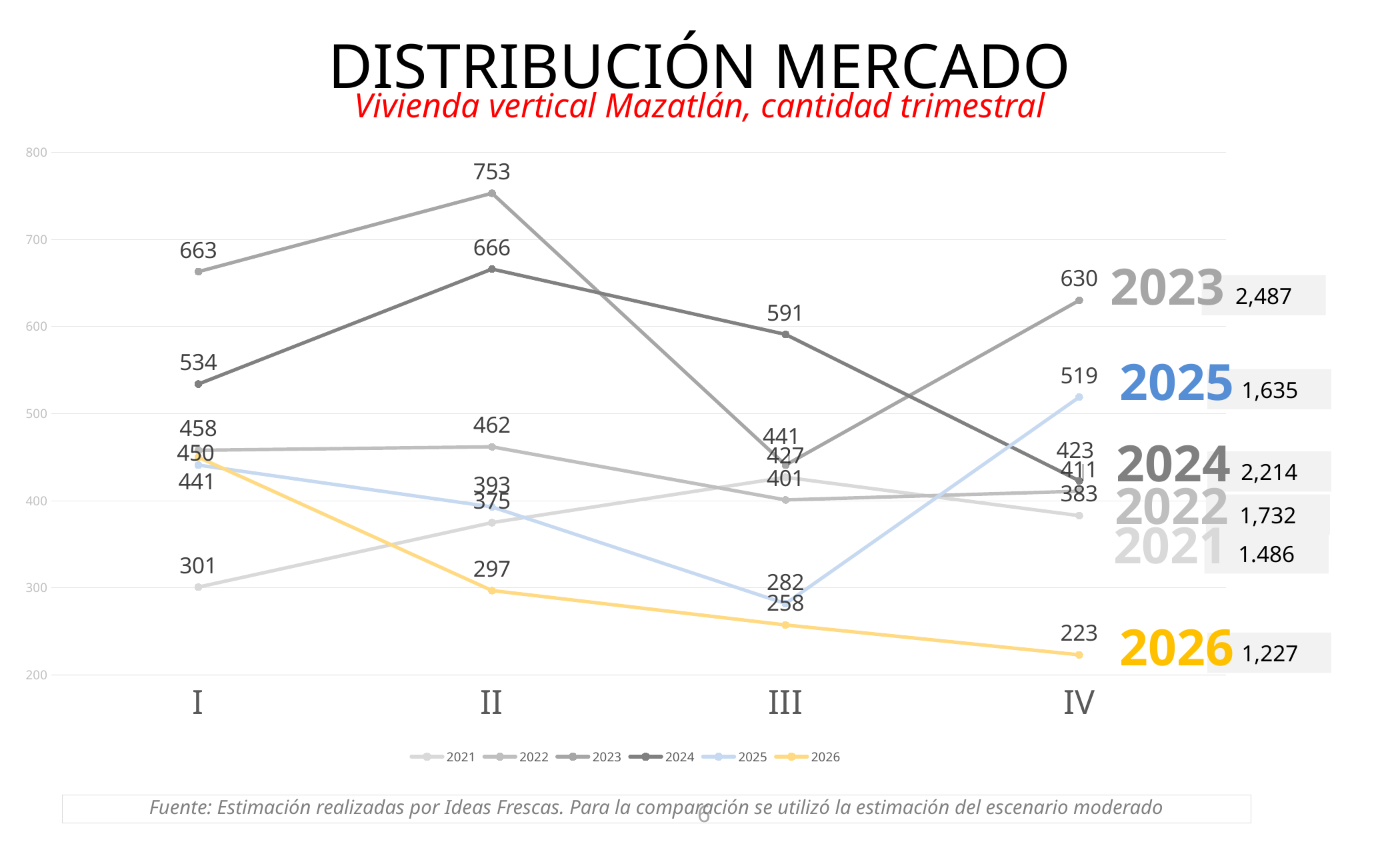
How many series does the legend list? 6 What is the value for 2021 in quarter I? 301 In which quarter does the 2023 series reach its highest value? II In quarter I, which is larger: the value for 2024 or the value for 2022? 2024 What is the value for 2025 in quarter IV? 519 Does the 2026 series rise or fall from quarter I to quarter IV? fall Which series has the lowest value in quarter IV? 2026 How many quarters are shown along the x axis? 4 What is the value for 2023 in quarter II? 753 What kind of chart is shown on the slide? line chart What is the difference between the 2023 values in quarter II and quarter III? 312 What is the value for 2024 in quarter III? 591